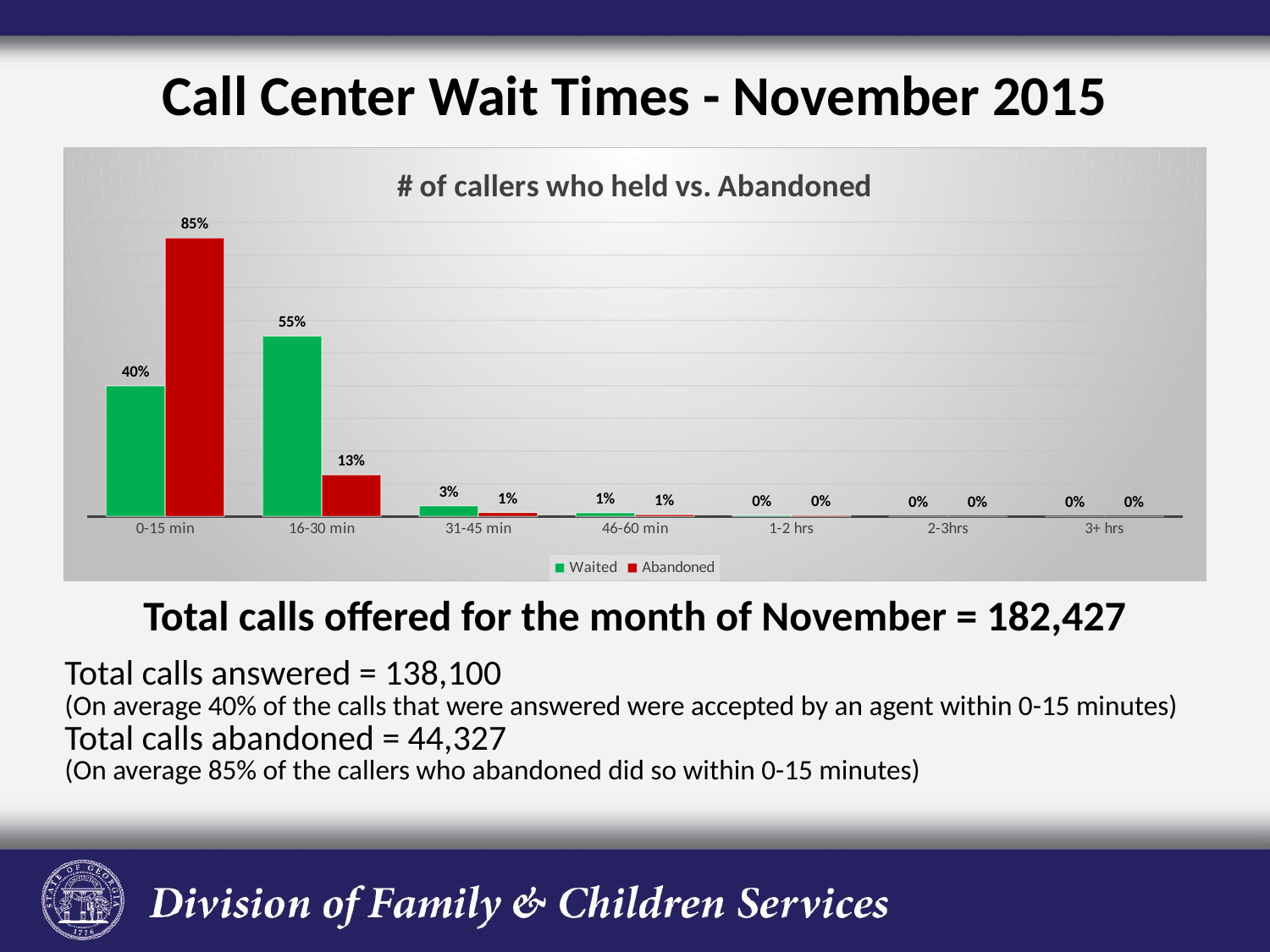
Which wait-time category has the highest Waited percentage? 16-30 min Which wait-time category has the highest Abandoned percentage? 0-15 min How many series does the legend list? 2 What is the Waited value for the 16-30 min category? 55% What is the difference between the Abandoned and Waited percentages for 0-15 min? 45% What percentage of callers waited 0-15 min? 40% What type of chart is shown on the slide? Bar chart What percentage of callers abandoned within 0-15 min? 85% How many wait-time categories are shown on the x axis? 7 What is the Abandoned value for the 16-30 min category? 13% For the 31-45 min category, which is larger: Waited or Abandoned? Waited What is the difference between the Waited and Abandoned percentages for 16-30 min? 42%